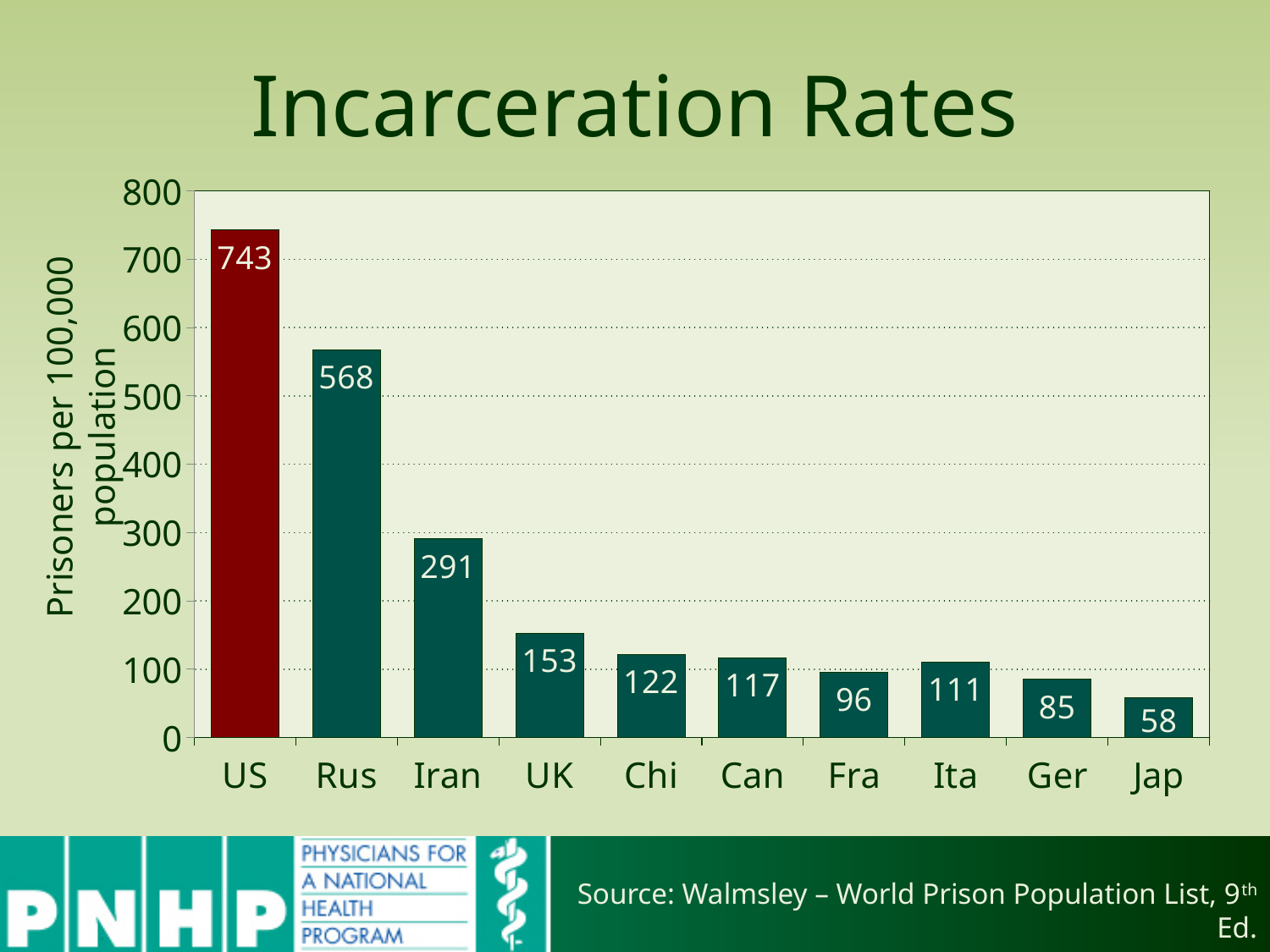
What is the difference between the incarceration rates of the US and Russia (Rus)? 175 What is the incarceration rate for Iran? 291 Which has a higher incarceration rate, Canada (Can) or Italy (Ita)? Can What is the incarceration rate for the US? 743 What is the incarceration rate for Germany (Ger)? 85 Is the value for France (Fra) greater or less than 100? less What is the difference between the incarceration rates of the UK and Japan (Jap)? 95 How many countries are shown in the chart? 10 Which country has the highest incarceration rate? US Which country has the lowest incarceration rate? Jap What is the label on the vertical axis of the chart? Prisoners per 100,000 population What kind of chart is shown on the slide? bar chart